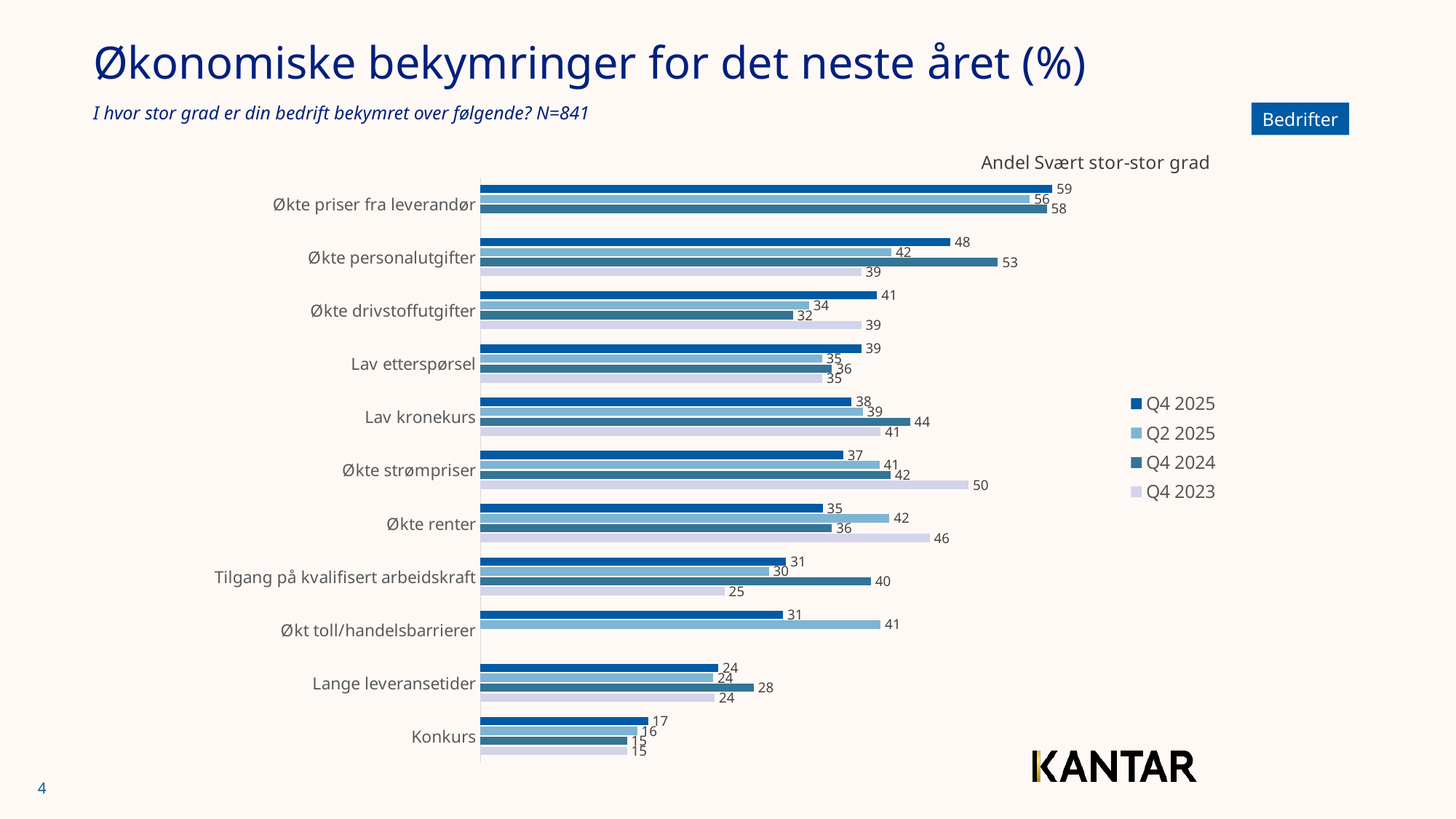
What kind of chart is shown on the slide? Bar chart What is the Q2 2025 value for Lav kronekurs? 39 What is the Q4 2024 value for Tilgang på kvalifisert arbeidskraft? 40 Which category has the highest Q4 2025 value? Økte priser fra leverandør What is the Q4 2023 value for Økte strømpriser? 50 For Økte renter, which is larger: the Q2 2025 value or the Q4 2025 value? Q2 2025 How many series does the legend list? 4 For Økte personalutgifter, how much higher is the Q4 2024 value than the Q4 2025 value? 5 What is the Q4 2025 value for Økte priser fra leverandør? 59 For Økt toll/handelsbarrierer, what is the difference between the Q2 2025 and Q4 2025 values? 10 How many categories are shown on the chart? 11 Which category has the lowest Q4 2025 value? Konkurs